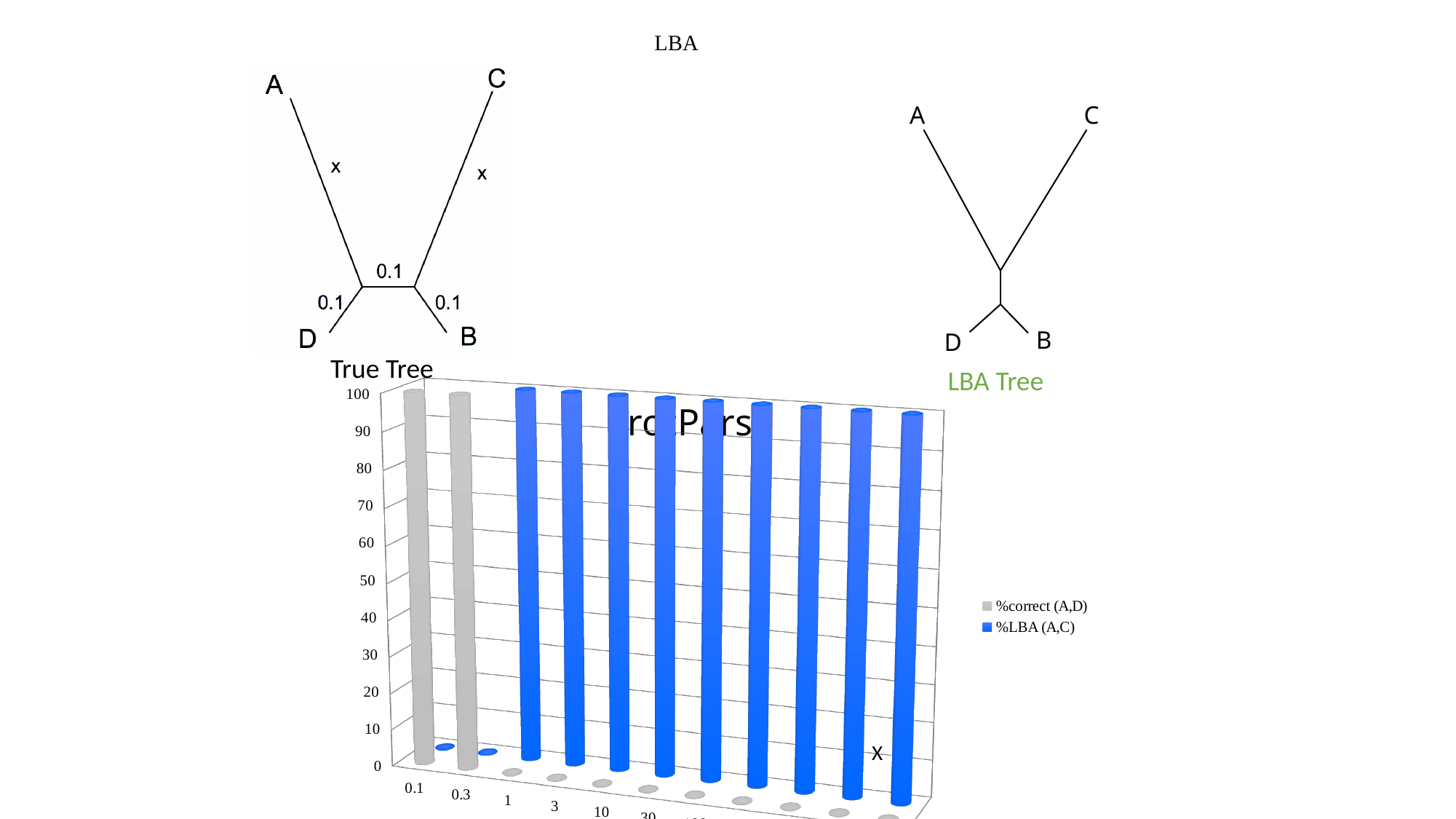
Is the value of %LBA (A,C) at category 1 greater or less than 90? greater Is the value of %correct (A,D) at category 3 greater or less than 10? less How many series does the chart legend list? 2 Does the %LBA (A,C) series rise or fall going from category 0.3 to category 1? rise What are the two series named in the chart legend? %correct (A,D) and %LBA (A,C) For how many categories is the %correct (A,D) bar above 50? 2 Is the value of %LBA (A,C) at category 0.1 greater or less than 10? less At category 0.3, which series has the larger value, %correct (A,D) or %LBA (A,C)? %correct (A,D) Which colour represents the %LBA (A,C) series in the chart? blue What kind of chart is shown on the slide? bar chart At category 10, which series has the larger value, %correct (A,D) or %LBA (A,C)? %LBA (A,C)